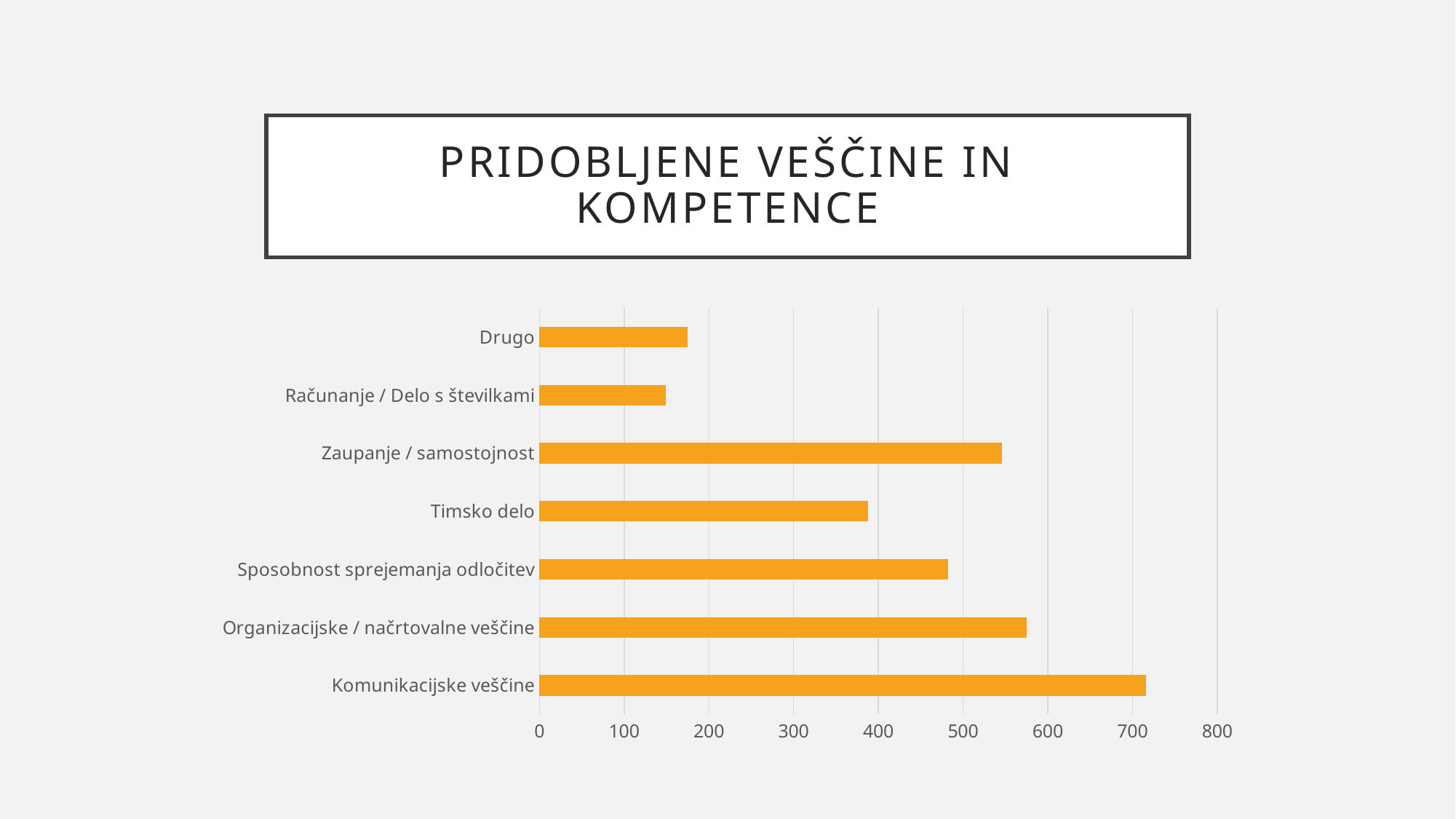
Which is larger, the value for Timsko delo or the value for Sposobnost sprejemanja odločitev? Sposobnost sprejemanja odločitev Is the value for Sposobnost sprejemanja odločitev greater or less than 500? less Which category has the lowest value? Računanje / Delo s številkami Is the value for Organizacijske / načrtovalne veščine greater or less than 500? greater Which category has the highest value? Komunikacijske veščine Is the value for Računanje / Delo s številkami greater or less than 200? less How many categories are shown in the chart? 7 What is the title of the slide? PRIDOBLJENE VEŠČINE IN KOMPETENCE What kind of chart is shown on the slide? bar chart Which is larger, the value for Drugo or the value for Zaupanje / samostojnost? Zaupanje / samostojnost